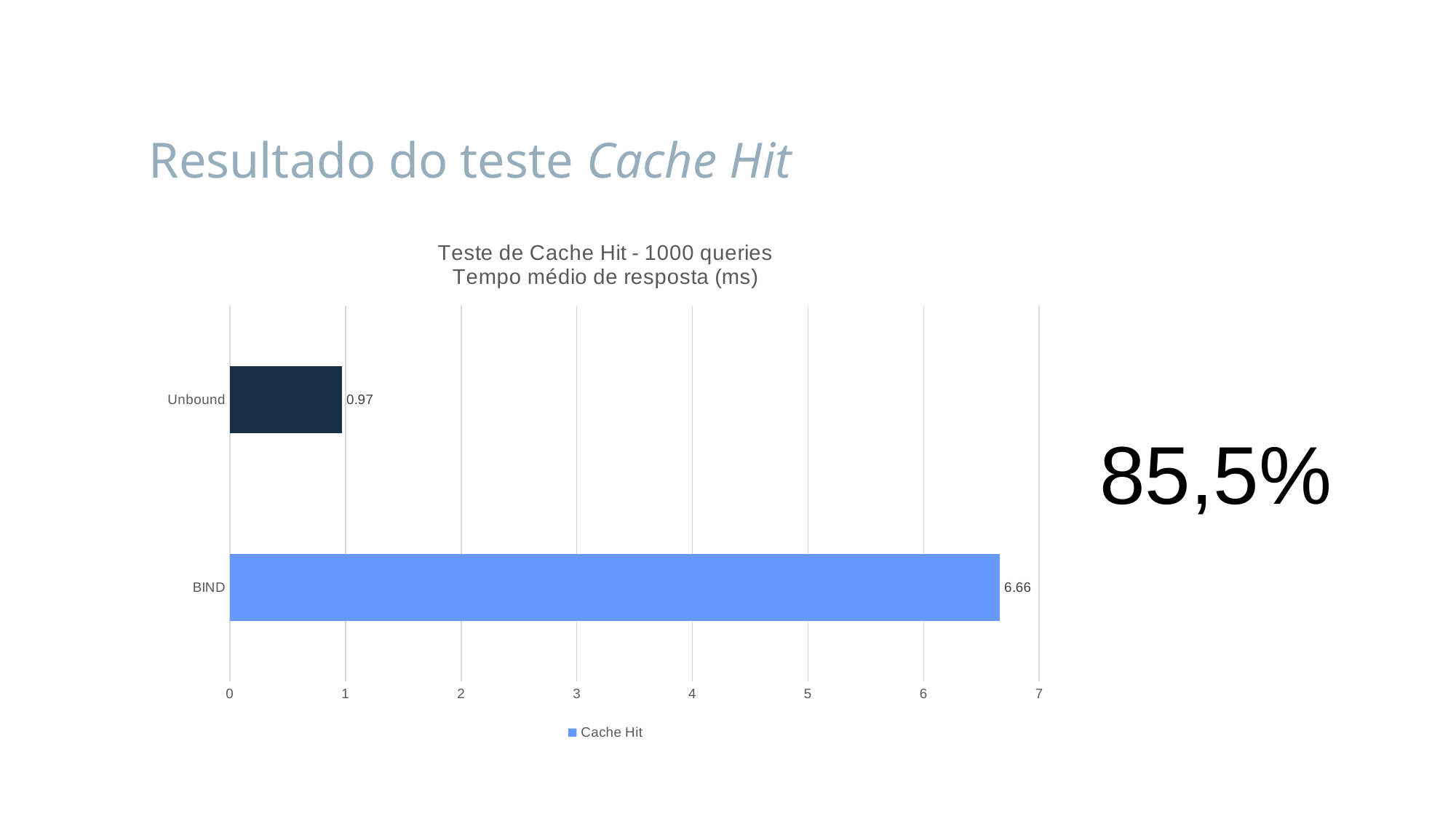
What is the average response time for Unbound? 0.97 Which category has the highest average response time? BIND Is the value for BIND greater or less than 6? greater What kind of chart is shown on the slide? bar chart What is the average response time for BIND? 6.66 Is the value for Unbound greater or less than 1? less What is the difference between the BIND and Unbound response times? 5.69 What is the name of the series in the legend? Cache Hit How many series does the legend list? 1 Which category has the lowest average response time? Unbound How many categories are shown in the chart? 2 Which has a larger value, BIND or Unbound? BIND